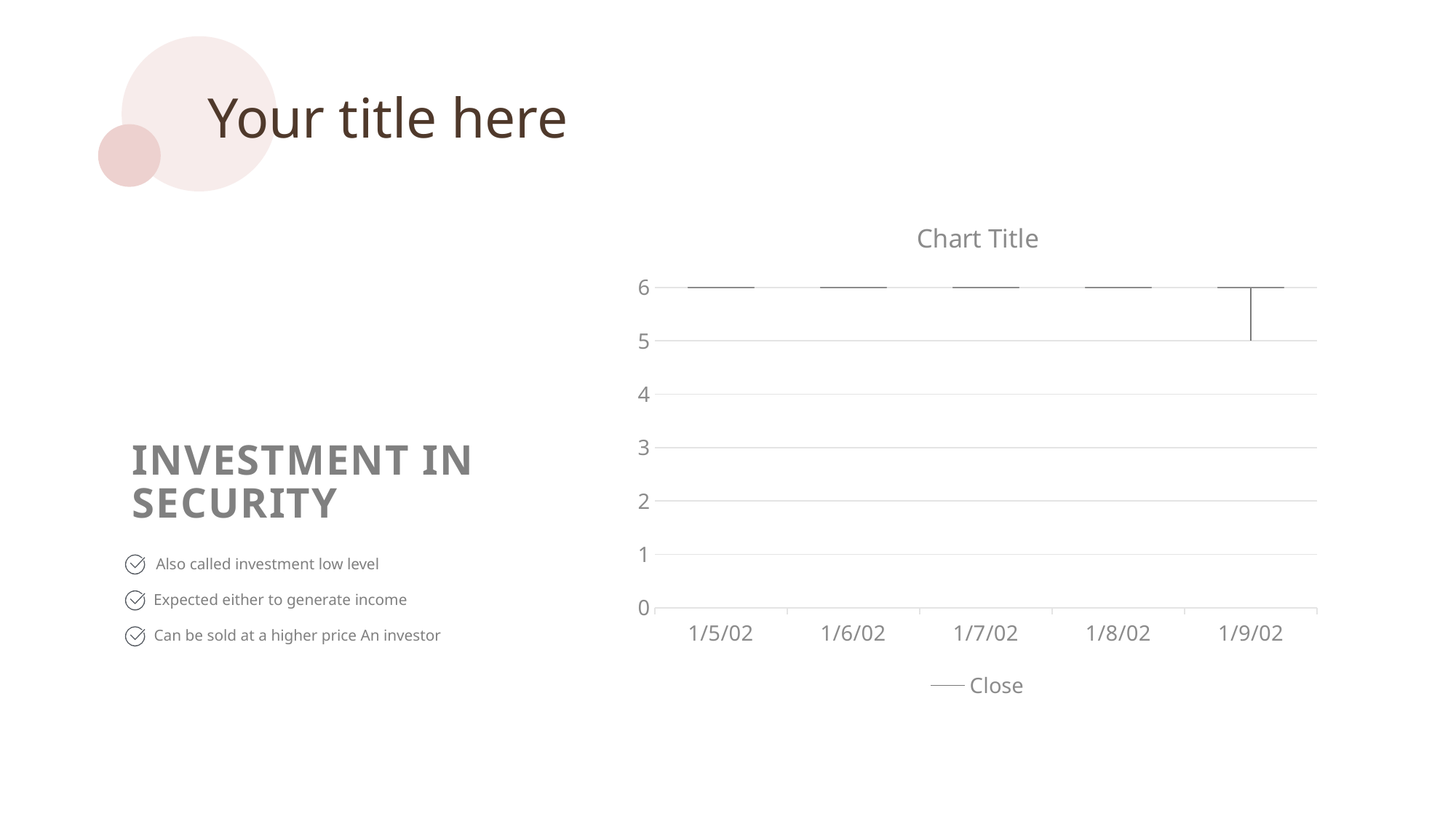
What is the last date shown on the x axis? 1/9/02 What is the first date shown on the x axis? 1/5/02 How many dates are shown on the x axis of the chart? 5 How many series does the legend list? 1 What is the title of the chart? Chart Title Is the Close value for 1/6/02 greater or less than 3? greater Is the Close value for 1/8/02 greater or less than 4? greater What series does the chart legend list? Close What is the highest value shown on the vertical axis? 6